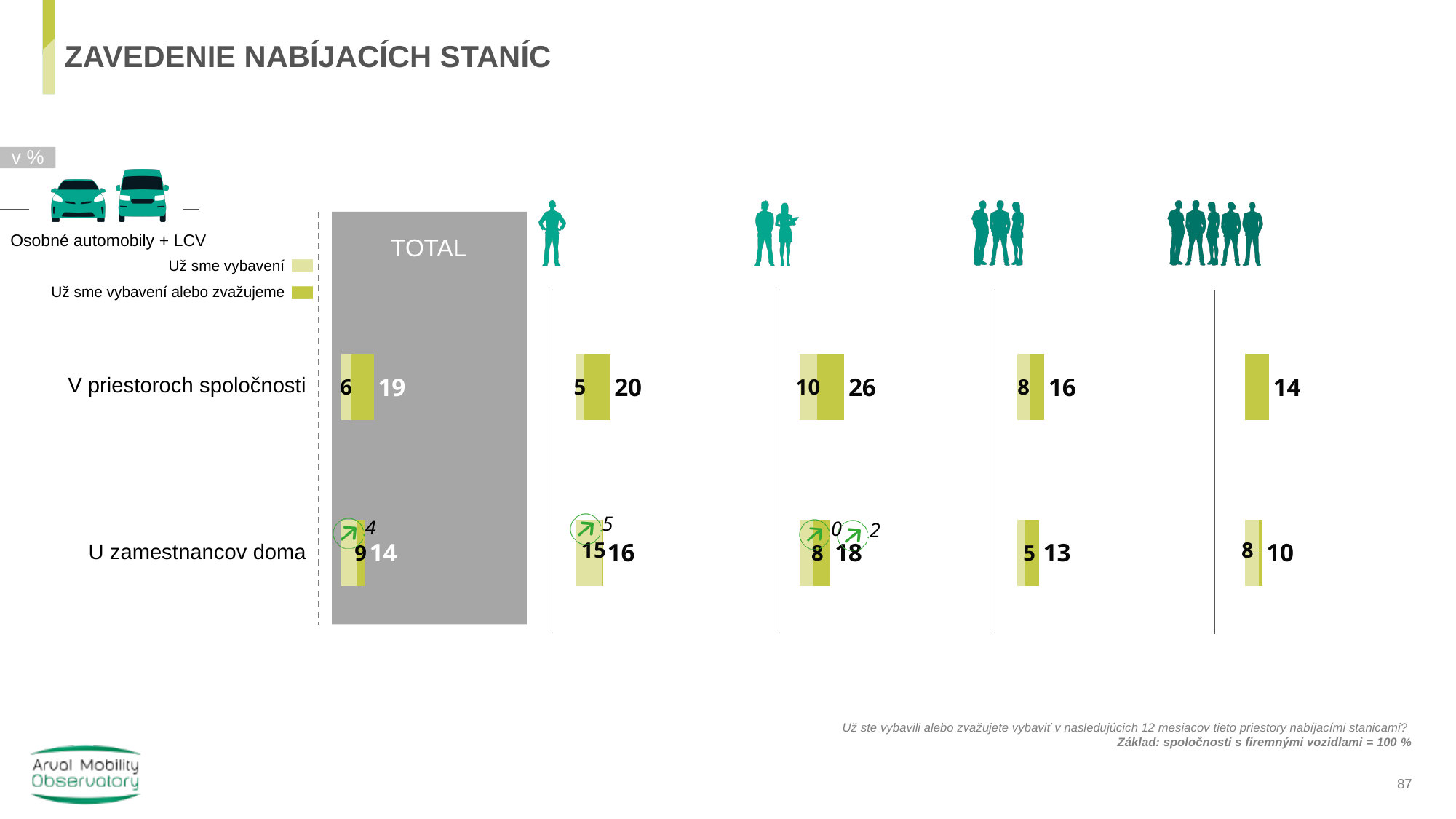
In the column with the single-person icon, what is the value for "Už sme vybavení" for "U zamestnancov doma"? 15 What kind of chart is shown on the slide? Bar chart In the TOTAL column, what is the value for "Už sme vybavení" for "U zamestnancov doma"? 9 How many series does the legend list? 2 In the column with the two-person icon, what is the value for "Už sme vybavení alebo zvažujeme" for "V priestoroch spoločnosti"? 26 In the TOTAL column, what is the value for "Už sme vybavení alebo zvažujeme" for "U zamestnancov doma"? 14 In the TOTAL column, what is the value for "Už sme vybavení alebo zvažujeme" for "V priestoroch spoločnosti"? 19 In the TOTAL column, what is the difference between the "Už sme vybavení alebo zvažujeme" and "Už sme vybavení" values for "V priestoroch spoločnosti"? 13 In the TOTAL column, which is larger: the "Už sme vybavení alebo zvažujeme" value for "V priestoroch spoločnosti" or for "U zamestnancov doma"? V priestoroch spoločnosti (19) Across all columns, which column has the highest "Už sme vybavení alebo zvažujeme" value for "V priestoroch spoločnosti"? The column with the two-person icon (26) In the TOTAL column, what is the value for "Už sme vybavení" for "V priestoroch spoločnosti"? 6 What unit are the values on the chart expressed in? %